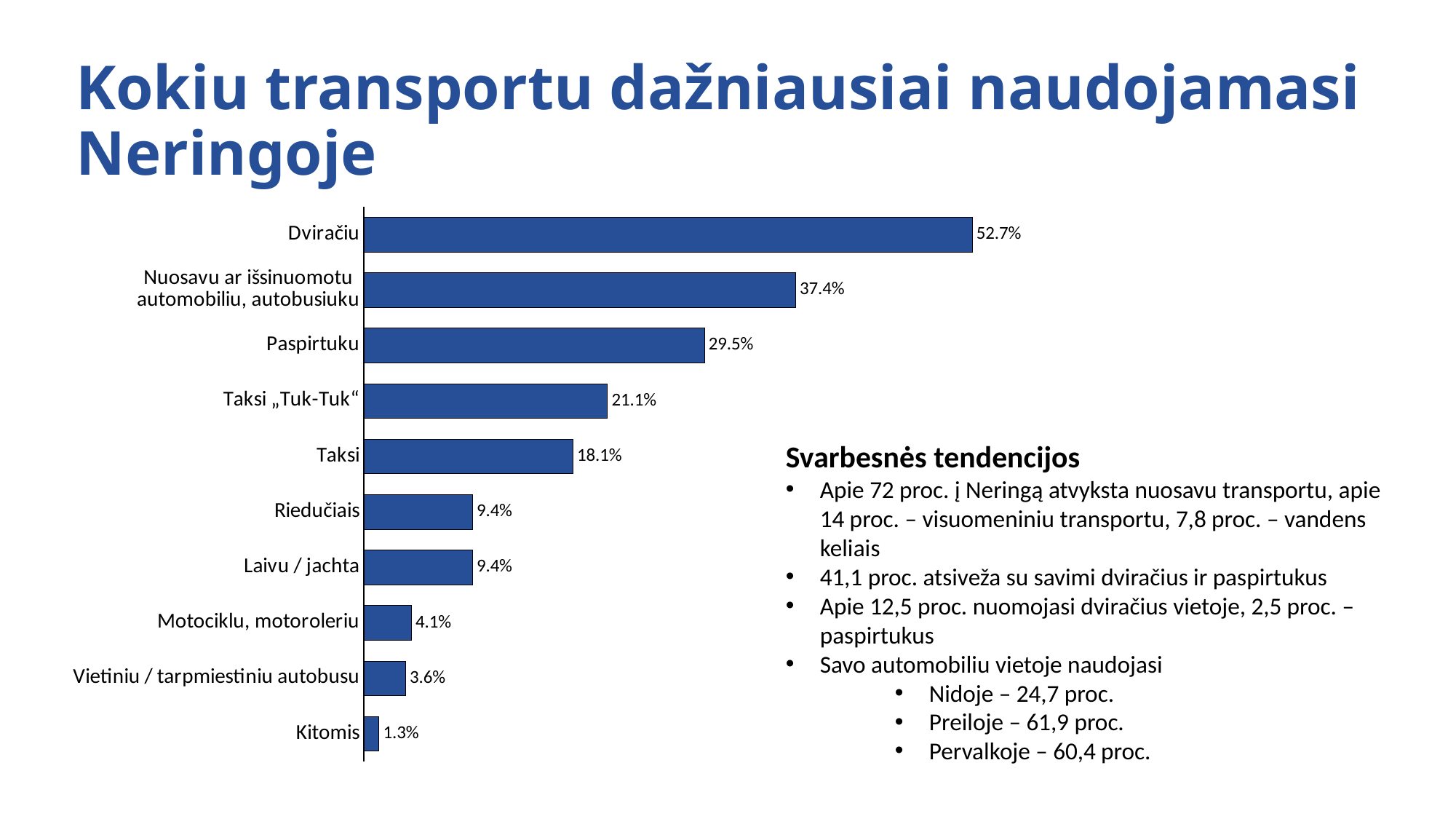
What is the value for Dviračiu? 52.7% How many categories does the chart show? 10 Which two categories share the same value of 9.4%? Riedučiais and Laivu / jachta What is the value for Taksi „Tuk-Tuk“? 21.1% What is the difference between the values for Taksi „Tuk-Tuk“ and Taksi? 3.0% Which is larger, the value for Paspirtuku or the value for Taksi? Paspirtuku Which category has the lowest value? Kitomis Which category has the highest value? Dviračiu What is the value for Paspirtuku? 29.5% What is the difference between the values for Dviračiu and Nuosavu ar išsinuomotu automobiliu, autobusiuku? 15.3% What is the value for Vietiniu / tarpmiestiniu autobusu? 3.6% What kind of chart is shown on the slide? Bar chart